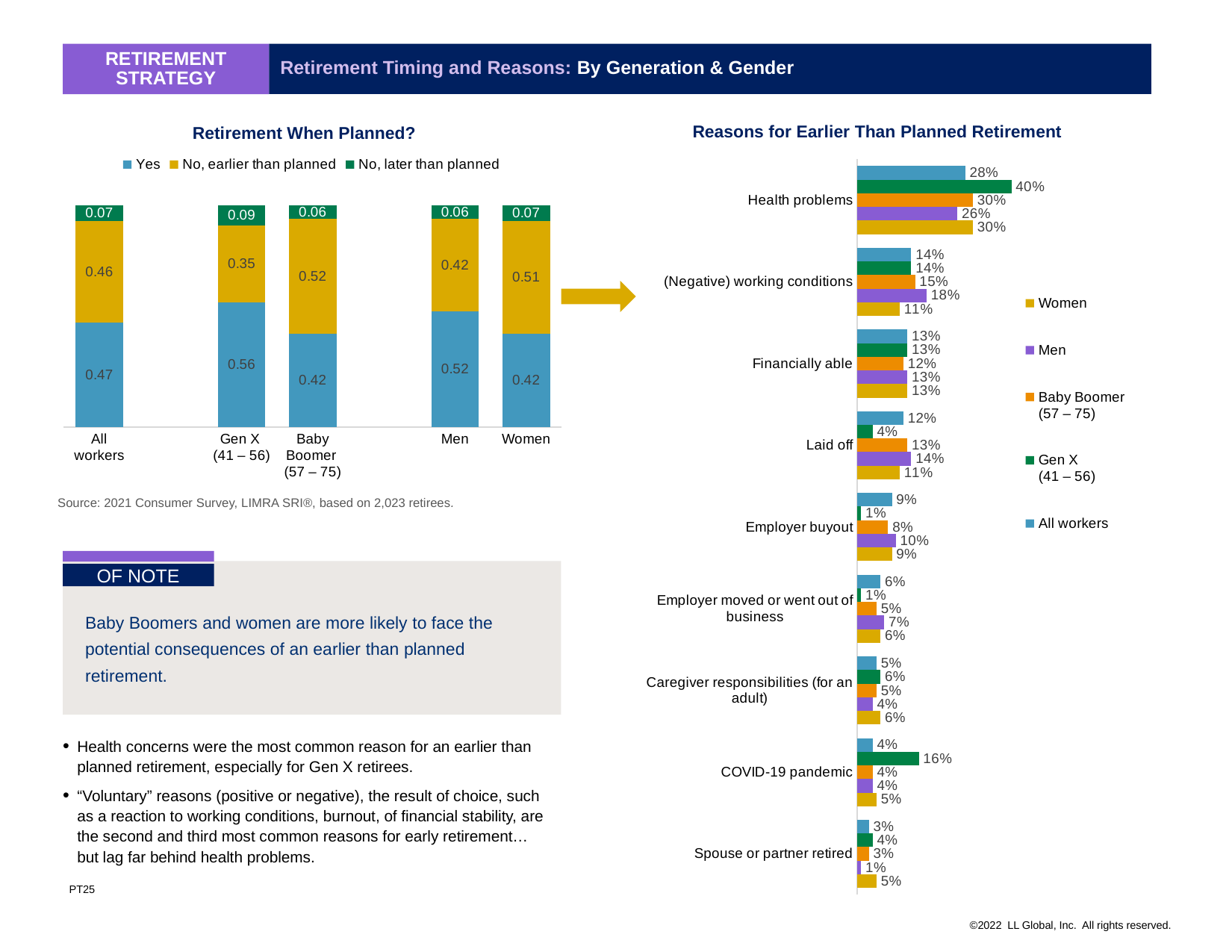
What kind of chart is 'Reasons for Earlier Than Planned Retirement'? bar chart In the 'Retirement When Planned?' chart, how many series does the legend list? 3 In the 'Retirement When Planned?' chart, what is the difference between the 'No, earlier than planned' values for Women and Men? 0.09 In the 'Reasons for Earlier Than Planned Retirement' chart, what is the Gen X (41 – 56) value for Health problems? 40% In the 'Retirement When Planned?' chart, what is the 'No, earlier than planned' value for Baby Boomer (57 – 75)? 0.52 In the 'Reasons for Earlier Than Planned Retirement' chart, how many reasons are listed on the axis? 9 In the 'Reasons for Earlier Than Planned Retirement' chart, is the Gen X (41 – 56) value for COVID-19 pandemic larger or smaller than the Women value? larger In the 'Retirement When Planned?' chart, what is the 'Yes' value for Gen X (41 – 56)? 0.56 In the 'Retirement When Planned?' chart, which category has the highest 'No, later than planned' value? Gen X (41 – 56) In the 'Reasons for Earlier Than Planned Retirement' chart, what is the Men value for (Negative) working conditions? 18% In the 'Reasons for Earlier Than Planned Retirement' chart, which group has the lowest value for Laid off? Gen X (41 – 56) In the 'Retirement When Planned?' chart, what is the total of the stacked bar for All workers? 1.00